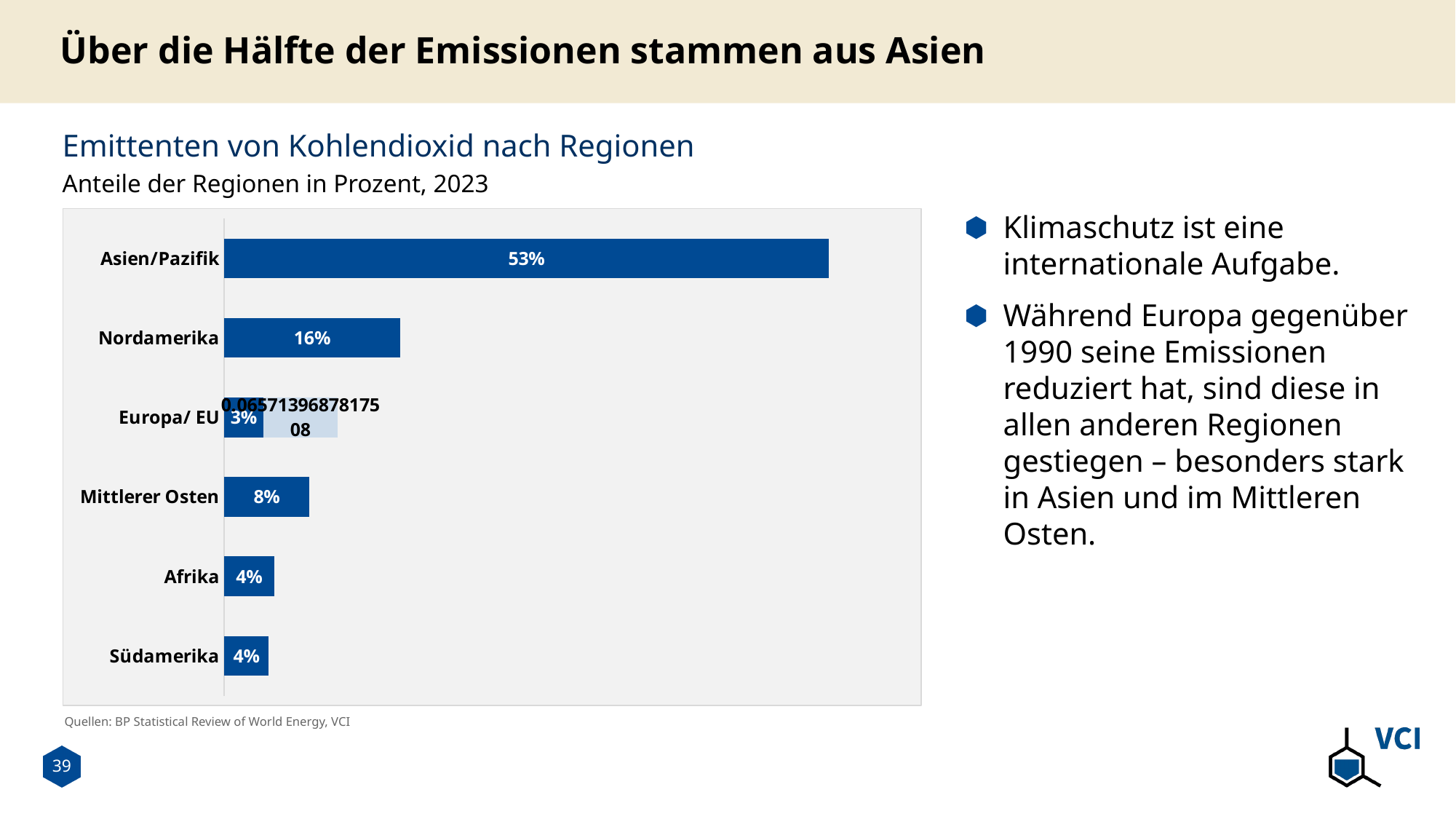
What is the value for Nordamerika? 16% What is the value for Afrika? 4% What is the value for Mittlerer Osten? 8% Which is larger, the value for Nordamerika or the value for Mittlerer Osten? Nordamerika What is the value for Südamerika? 4% What kind of chart is shown on the slide? Bar chart What is the value for Asien/Pazifik? 53% What is the difference between the values for Asien/Pazifik and Nordamerika? 37 percentage points How many regions are shown in the chart? 6 Which year does the chart's data refer to? 2023 Which region has the highest share? Asien/Pazifik What is the title of the chart? Emittenten von Kohlendioxid nach Regionen